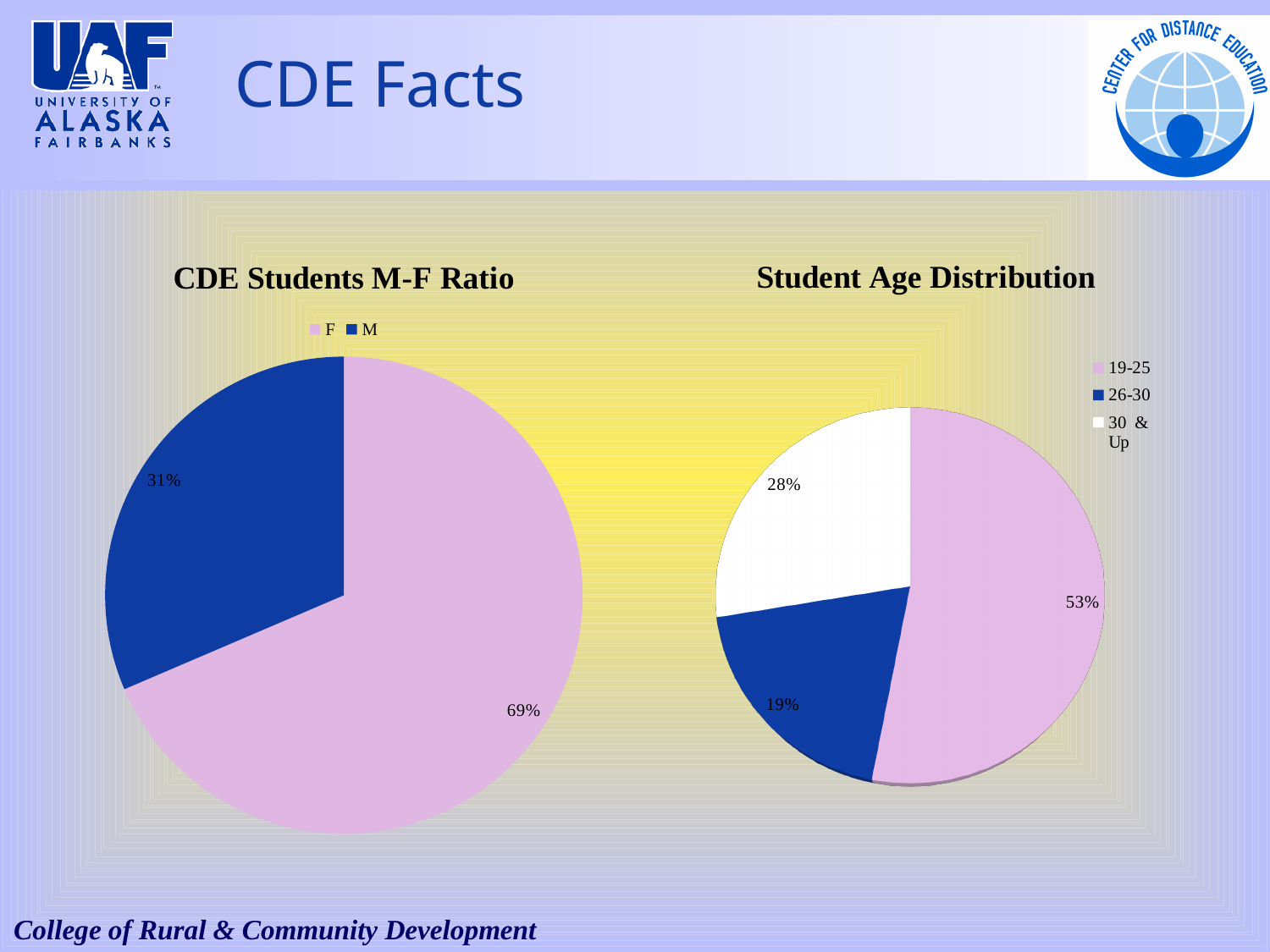
In the 'Student Age Distribution' chart, which age group has the smallest slice? 26-30 How many categories does the legend of the 'Student Age Distribution' chart list? 3 In the 'CDE Students M-F Ratio' chart, which category has the largest slice? F What kind of chart is 'CDE Students M-F Ratio'? Pie chart In the 'Student Age Distribution' chart, what is the difference between the 19-25 share and the 30 & Up share? 25% In the 'CDE Students M-F Ratio' chart, what is the difference between the F and M shares? 38% In the 'Student Age Distribution' chart, what share of students is aged 19-25? 53% In the 'CDE Students M-F Ratio' chart, what share of students is M? 31% In the 'Student Age Distribution' chart, what share of students is aged 26-30? 19% In the 'Student Age Distribution' chart, which is larger: the 30 & Up slice or the 26-30 slice? 30 & Up